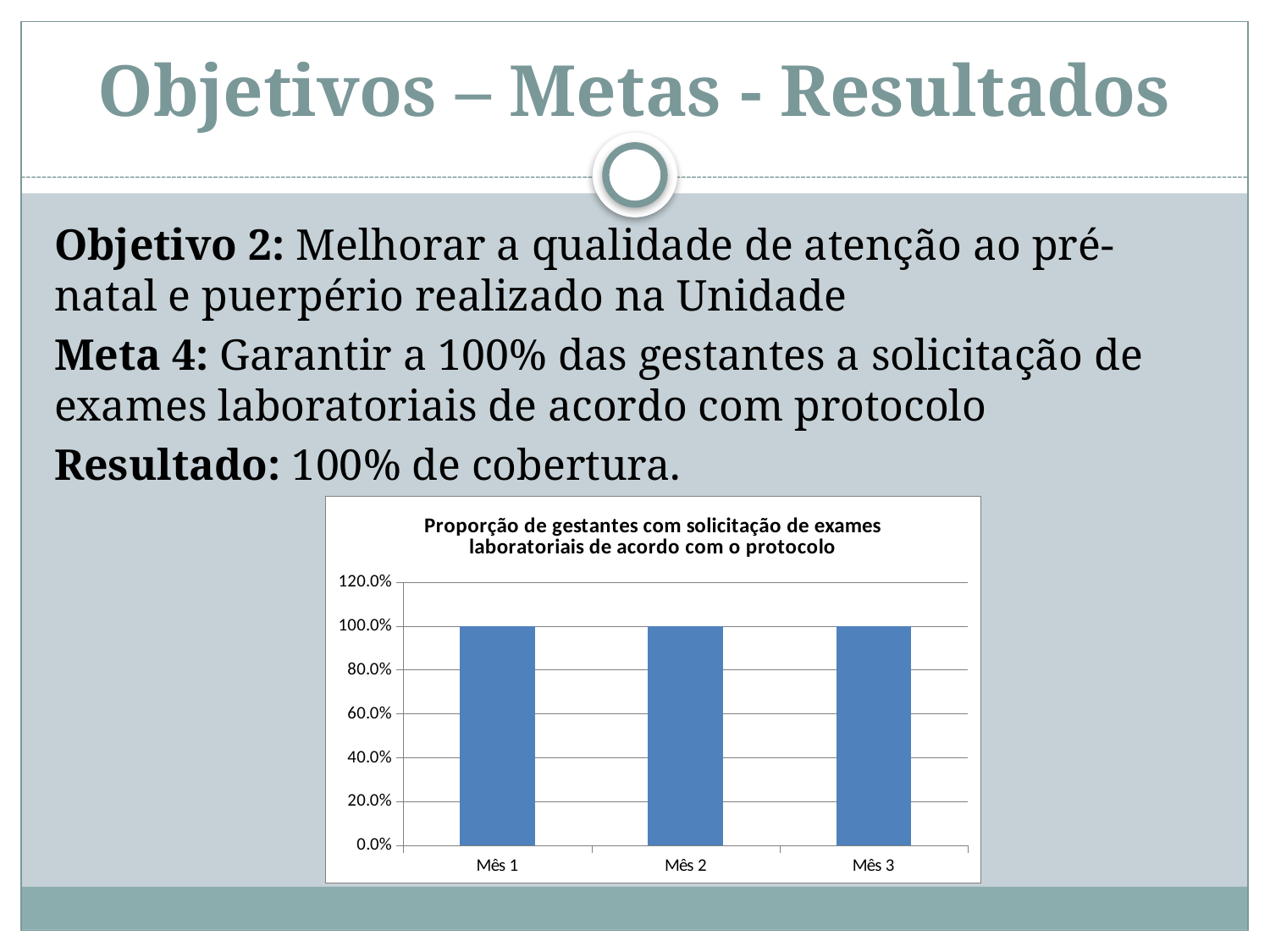
What is the highest value shown on the chart's y axis? 120.0% What is the value for Mês 2? 100.0% What is the difference between the values for Mês 1 and Mês 3? 0.0% Is the value for Mês 1 greater or less than 80.0%? greater Is the value for Mês 3 greater or less than 120.0%? less What is the value for Mês 3? 100.0% Is the value for Mês 2 greater or less than 60.0%? greater How many categories are shown on the x axis of the chart? 3 What is the value for Mês 1? 100.0% What is the title of the chart? Proporção de gestantes com solicitação de exames laboratoriais de acordo com o protocolo Do the values rise, fall or stay the same from Mês 1 to Mês 3? stay the same What kind of chart is shown on the slide? bar chart